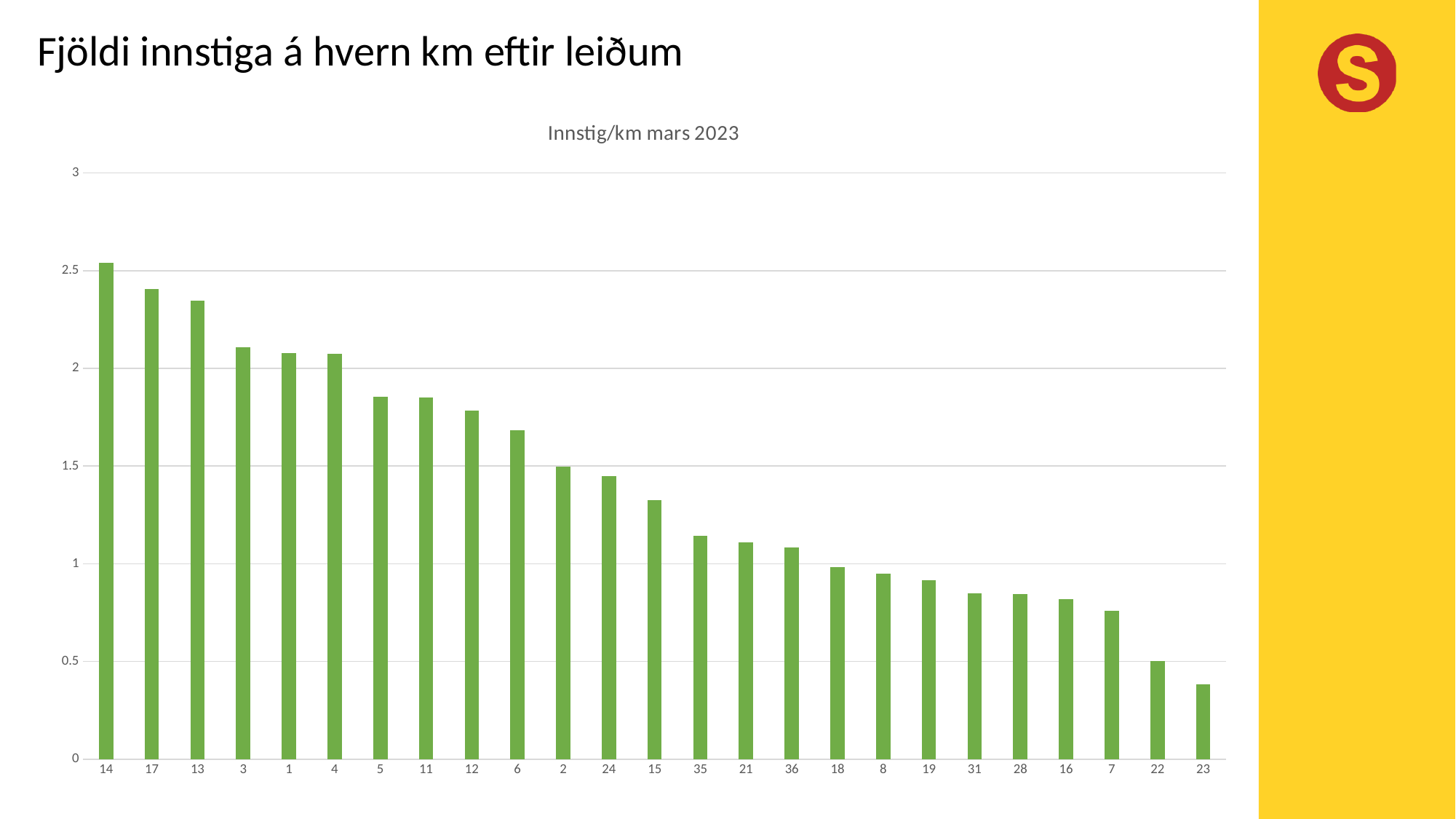
Is the value for route 23 greater or less than 0.5? less How many routes (categories) are plotted on the x axis? 25 Which has the larger value, route 13 or route 5? 13 Is the value for route 6 greater or less than 1.5? greater What kind of chart is shown on the slide? bar chart What is the title of the chart? Innstig/km mars 2023 Which route has the lowest value? 23 Do the values rise or fall from left to right along the x axis? fall Is the value for route 17 greater or less than 2.5? less Which route has the highest value? 14